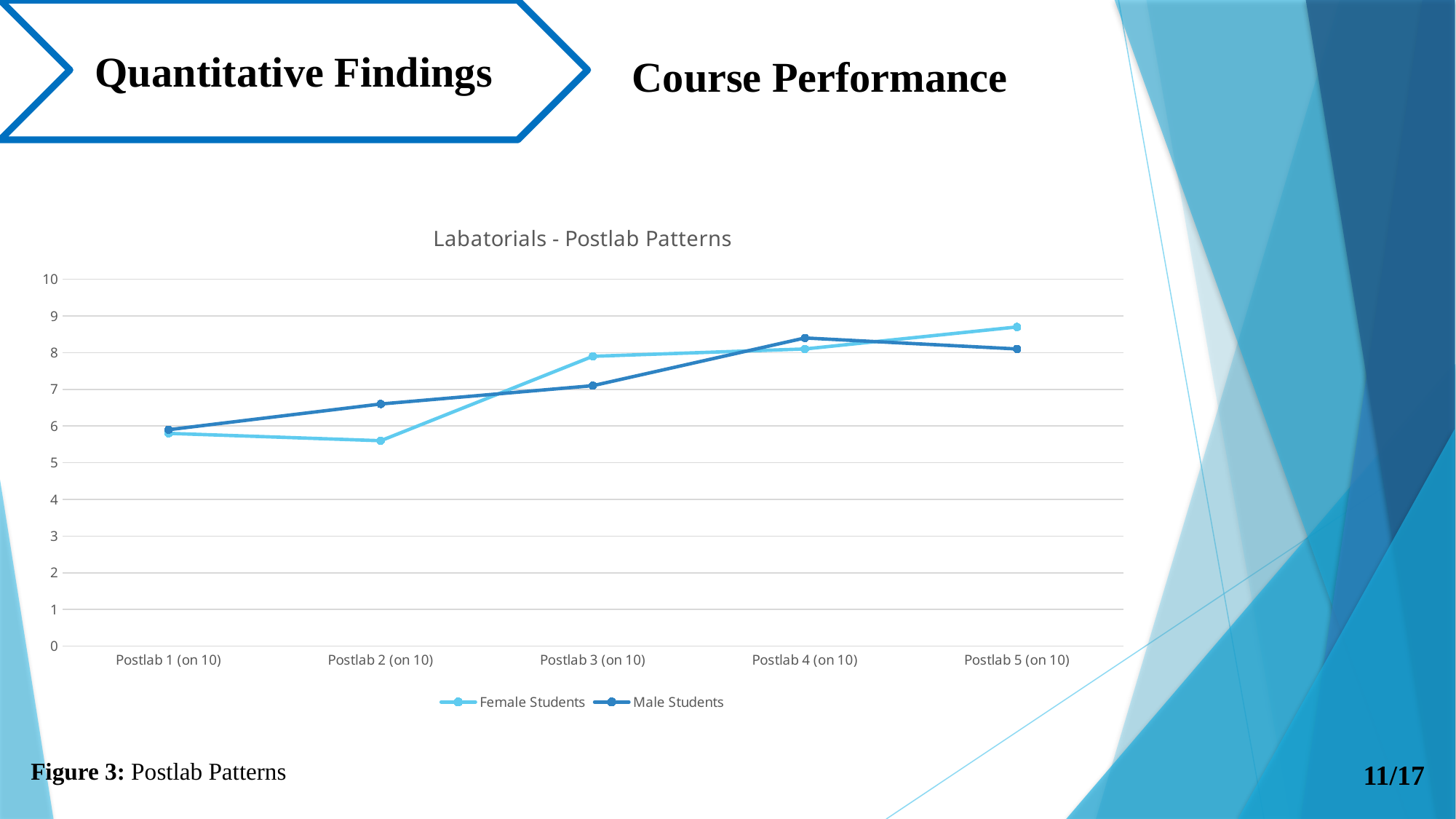
For Female Students, which postlab has the highest value? Postlab 5 (on 10) Is the value for Female Students at Postlab 2 (on 10) greater or less than 6? less At Postlab 5 (on 10), which series has the higher value, Female Students or Male Students? Female Students What is the title of the chart? Labatorials - Postlab Patterns At Postlab 2 (on 10), which series has the higher value, Female Students or Male Students? Male Students How many series does the legend list? 2 At Postlab 3 (on 10), which series has the higher value, Female Students or Male Students? Female Students How many postlab categories are shown on the x axis? 5 What type of chart is shown on the slide? line chart For Male Students, which postlab has the highest value? Postlab 4 (on 10) For Female Students, which postlab has the lowest value? Postlab 2 (on 10) Which series is drawn in the lighter blue line? Female Students